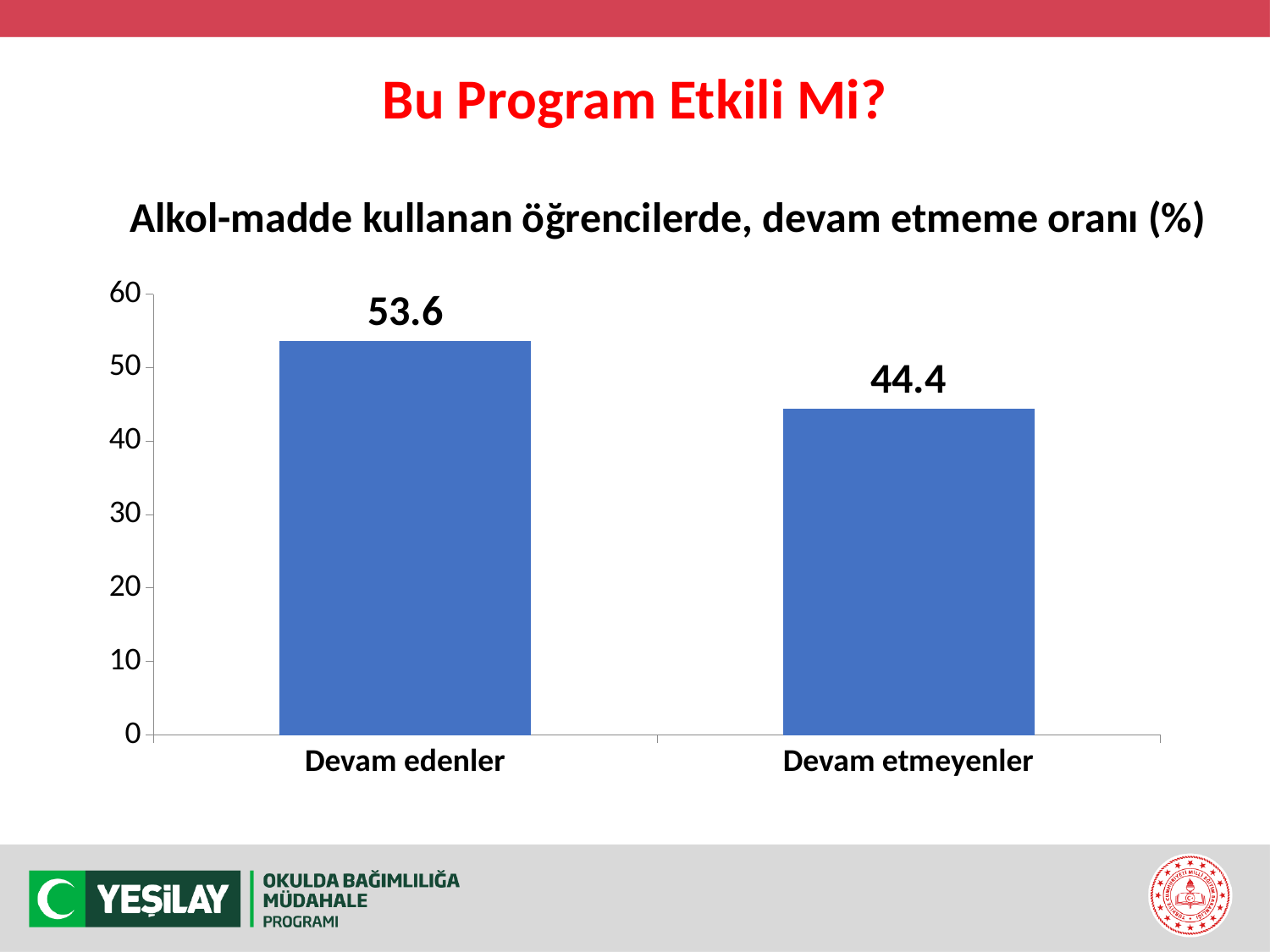
What is the difference between the values for Devam edenler and Devam etmeyenler? 9.2 What is the highest value shown on the vertical axis? 60 What kind of chart is shown on the slide? bar chart Which category has the highest value? Devam edenler Is the value for Devam etmeyenler greater or less than 50? less What is the value for Devam etmeyenler? 44.4 Which is larger, the value for Devam edenler or the value for Devam etmeyenler? Devam edenler What is the value for Devam edenler? 53.6 Is the value for Devam edenler greater or less than 50? greater Which category has the lowest value? Devam etmeyenler How many categories are shown in the chart? 2 What is the title of the chart? Alkol-madde kullanan öğrencilerde, devam etmeme oranı (%)